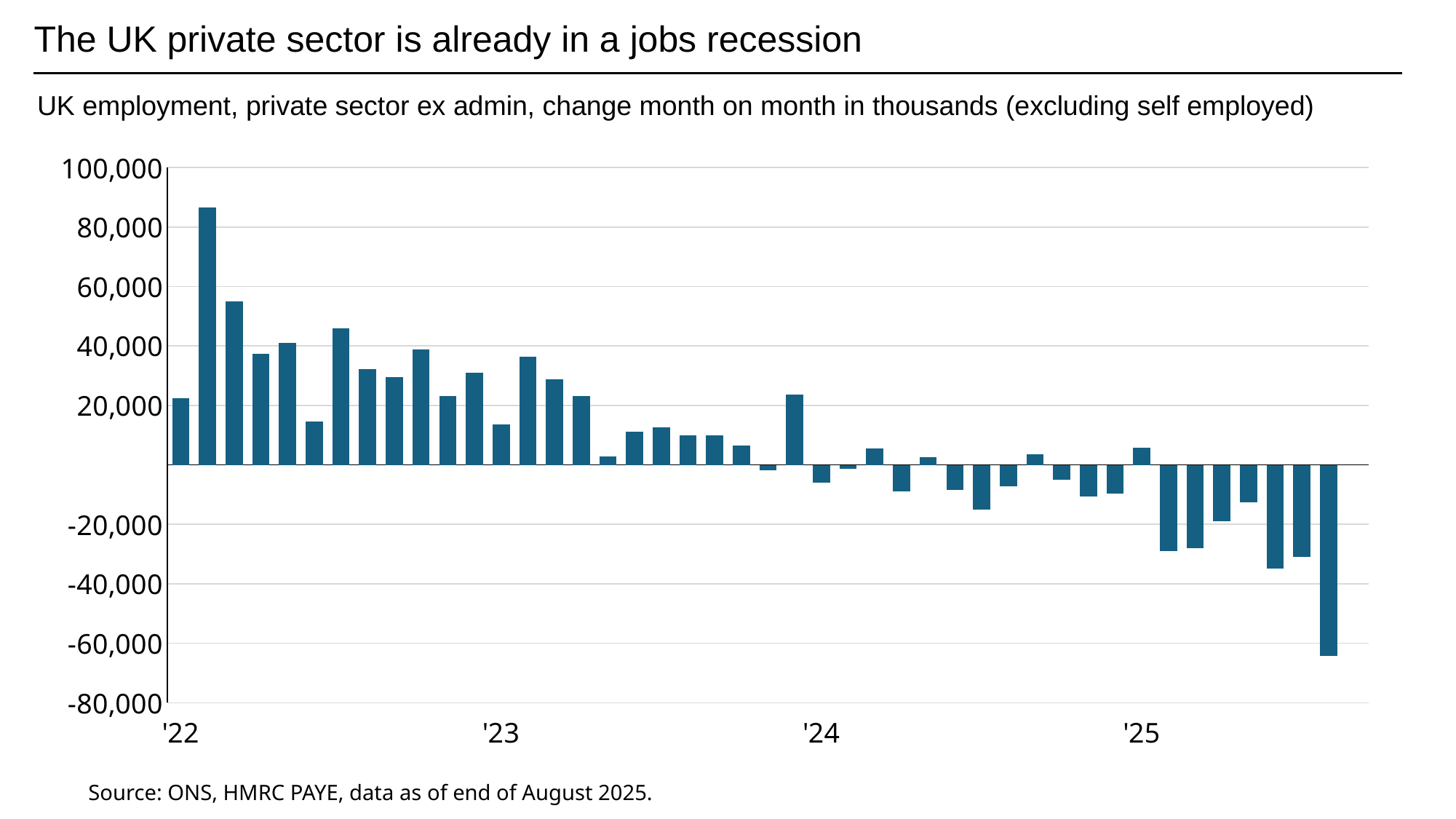
What is the title of the slide? The UK private sector is already in a jobs recession Is the value of the bar at the '25 tick greater or less than -20,000? greater What kind of chart is shown on the slide? bar chart Is the first bar in '22 larger or smaller than the second bar in '22? smaller Is the value of the tallest bar in '22 greater or less than 80,000? greater What is the source cited beneath the chart? ONS, HMRC PAYE, data as of end of August 2025. Is the value of the bar at the '24 tick greater or less than 20,000? less Which bar shows the largest monthly increase in employment? the second bar, in early '22 Overall, do the monthly employment changes rise or fall from '22 to '25 along the x axis? fall Which bar shows the largest monthly decrease in employment? the last bar, the most recent month in '25